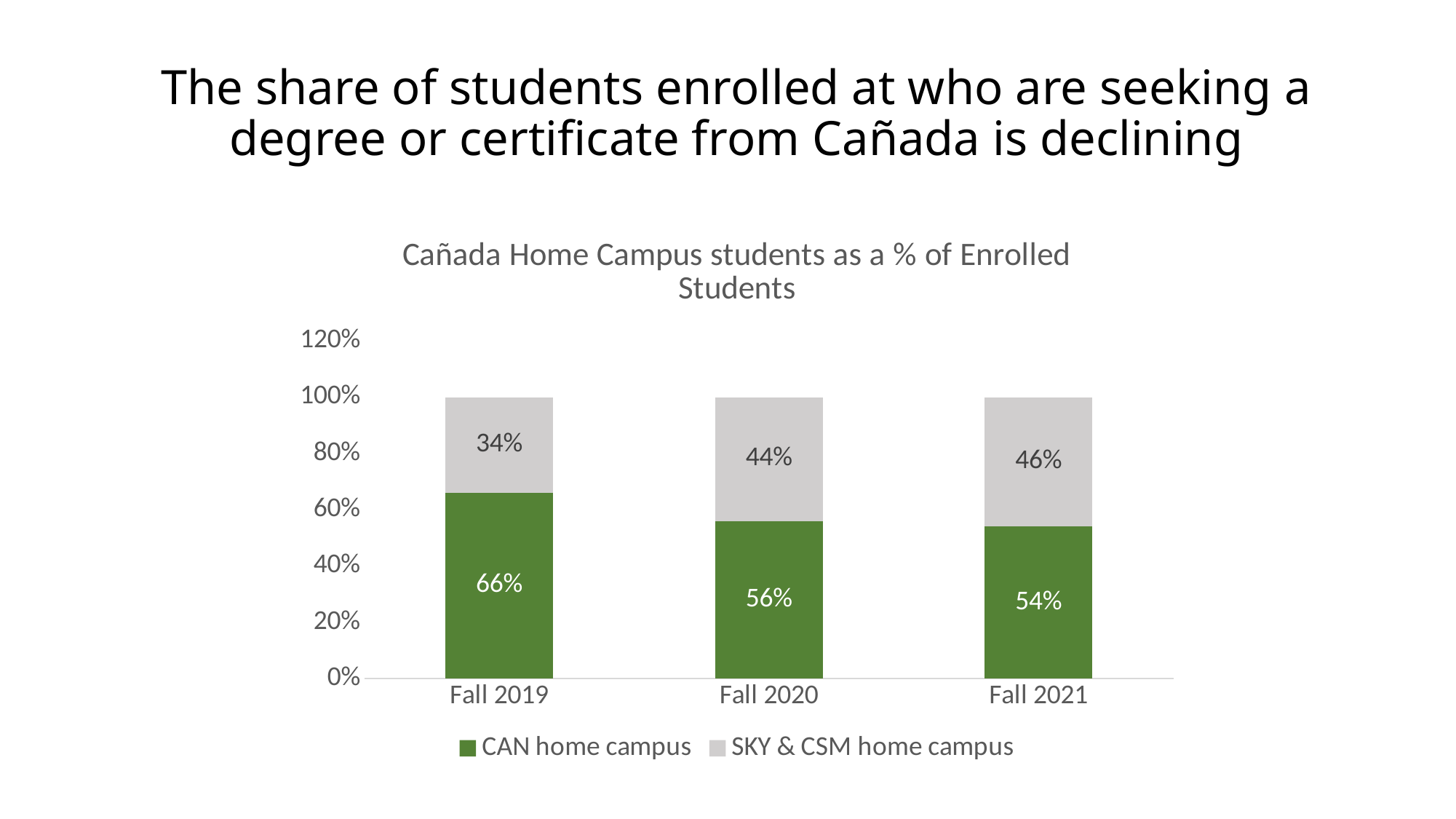
How many series does the legend list? 2 What is the value for SKY & CSM home campus in Fall 2021? 46% What is the difference between the CAN home campus share in Fall 2019 and Fall 2021? 12% In which year is the SKY & CSM home campus share lowest? Fall 2019 Which is larger in Fall 2020: the CAN home campus share or the SKY & CSM home campus share? CAN home campus In which year is the CAN home campus share highest? Fall 2019 Does the CAN home campus share rise or fall from Fall 2019 to Fall 2021? Fall How many years are shown on the x axis? 3 What is the value for CAN home campus in Fall 2020? 56% What kind of chart is shown? Stacked bar chart What is the title of the chart? Cañada Home Campus students as a % of Enrolled Students What is the value for CAN home campus in Fall 2019? 66%